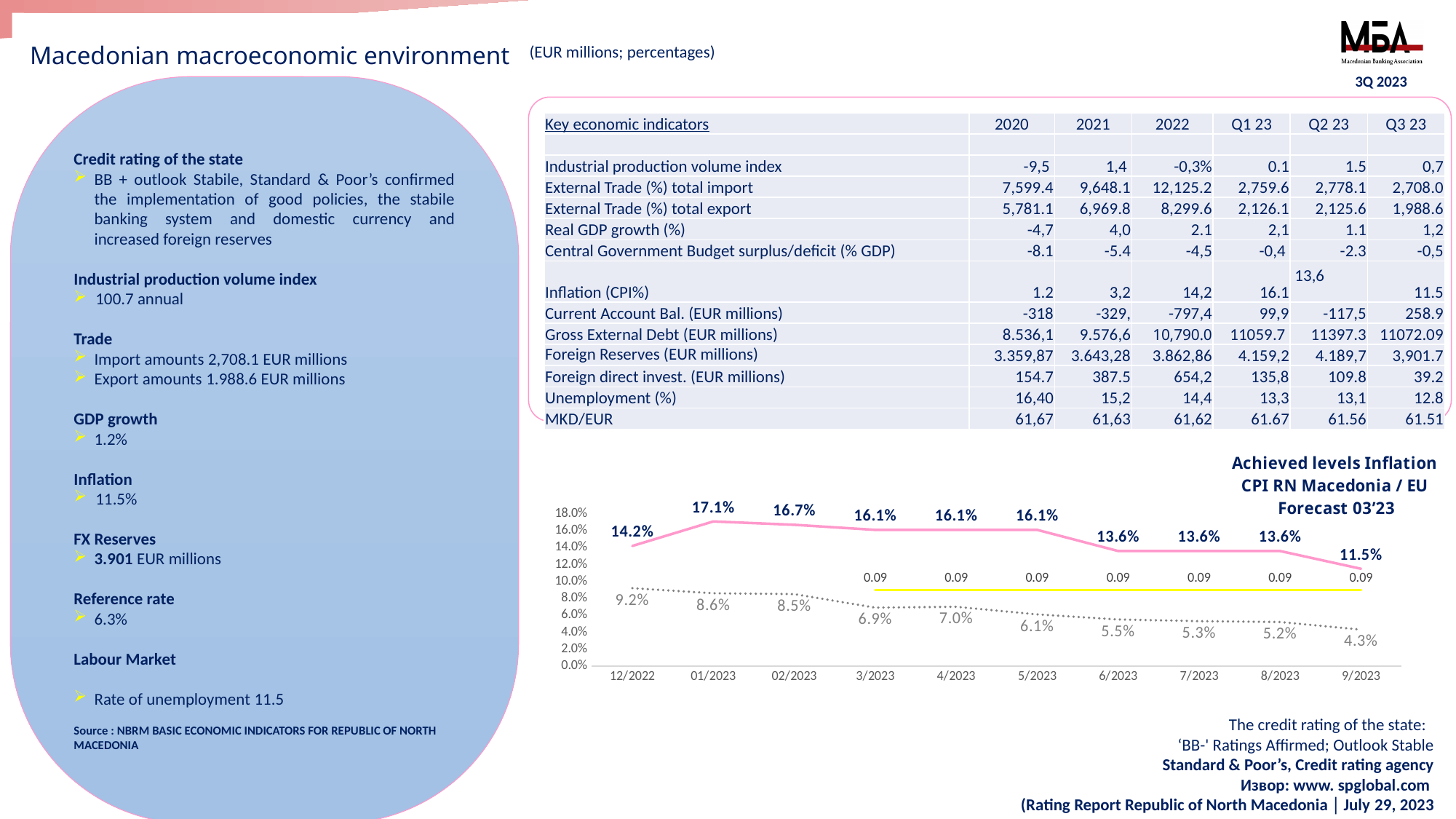
What kind of chart is shown on the slide? line chart At which time point does the upper (pink) line reach its highest value? 01/2023 What is the difference between the upper (pink) line value at 12/2022 and at 9/2023? 2.7% Which is larger at 6/2023: the upper (pink) line value or the lower (grey dotted) line value? the upper (pink) line value Is the value of the upper (pink) line at 9/2023 greater or less than 10.0%? greater What is the title of the chart? Achieved levels Inflation CPI RN Macedonia / EU Forecast 03'23 What is the value of the upper (pink) line at 01/2023? 17.1% What is the value of the lower (grey dotted) line at 9/2023? 4.3% At which time point does the lower (grey dotted) line reach its lowest value? 9/2023 What value is labelled on the flat yellow line from 3/2023 to 9/2023? 0.09 Does the lower (grey dotted) line generally rise or fall from 12/2022 to 9/2023? fall How many time points are plotted along the x axis of the chart? 10